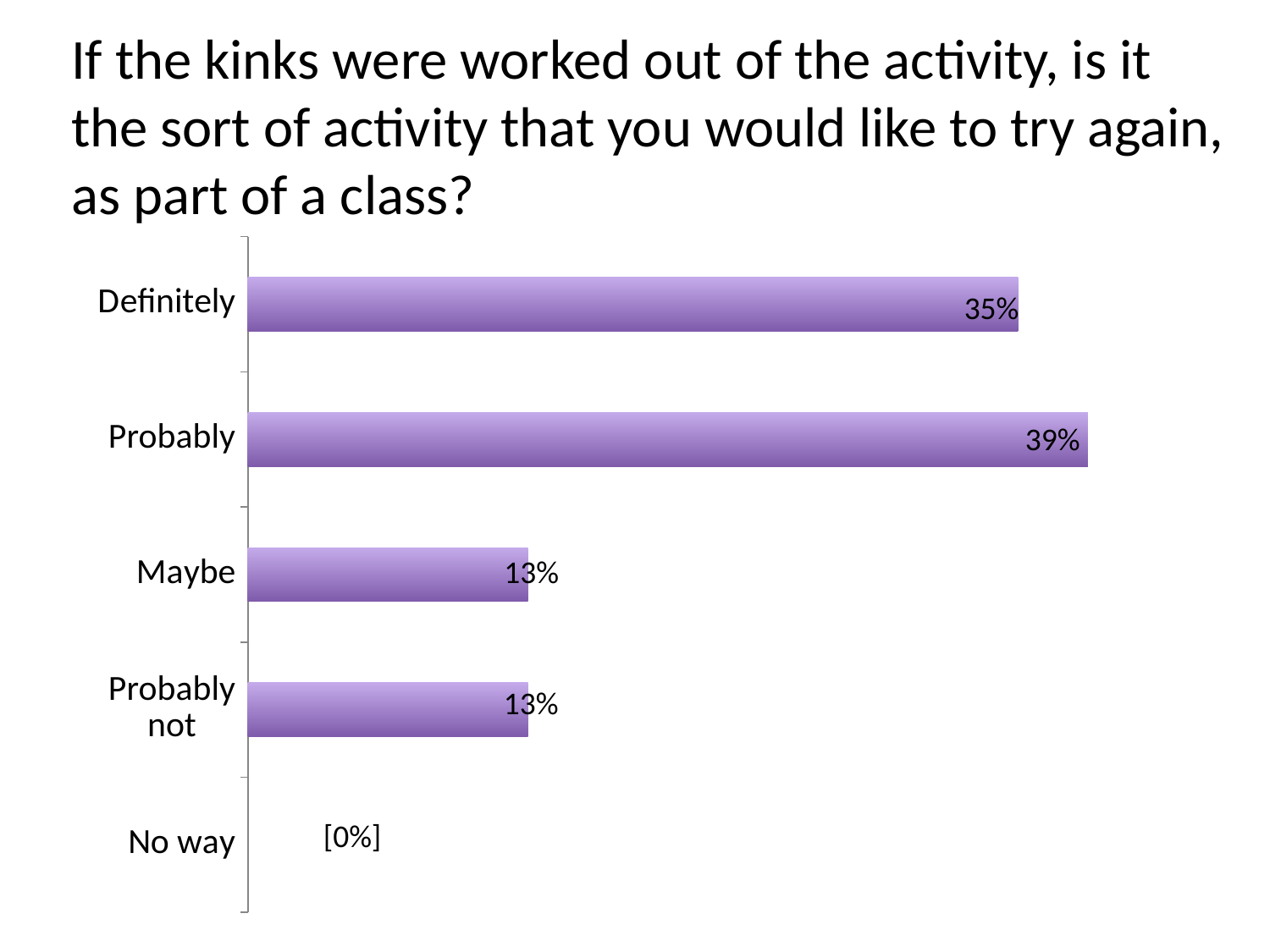
Which is larger, the value for Definitely or the value for Maybe? Definitely Which category has the lowest value? No way What is the difference between the values for Probably and Definitely? 4% What is the difference between the values for Definitely and Maybe? 22% What is the value for Maybe? 13% What is the value for No way? 0% How many categories are shown in the chart? 5 What is the value for Probably? 39% What colour are the bars in the chart? Purple What kind of chart is shown on the slide? Bar chart Which category has the highest value? Probably What is the value for Definitely? 35%